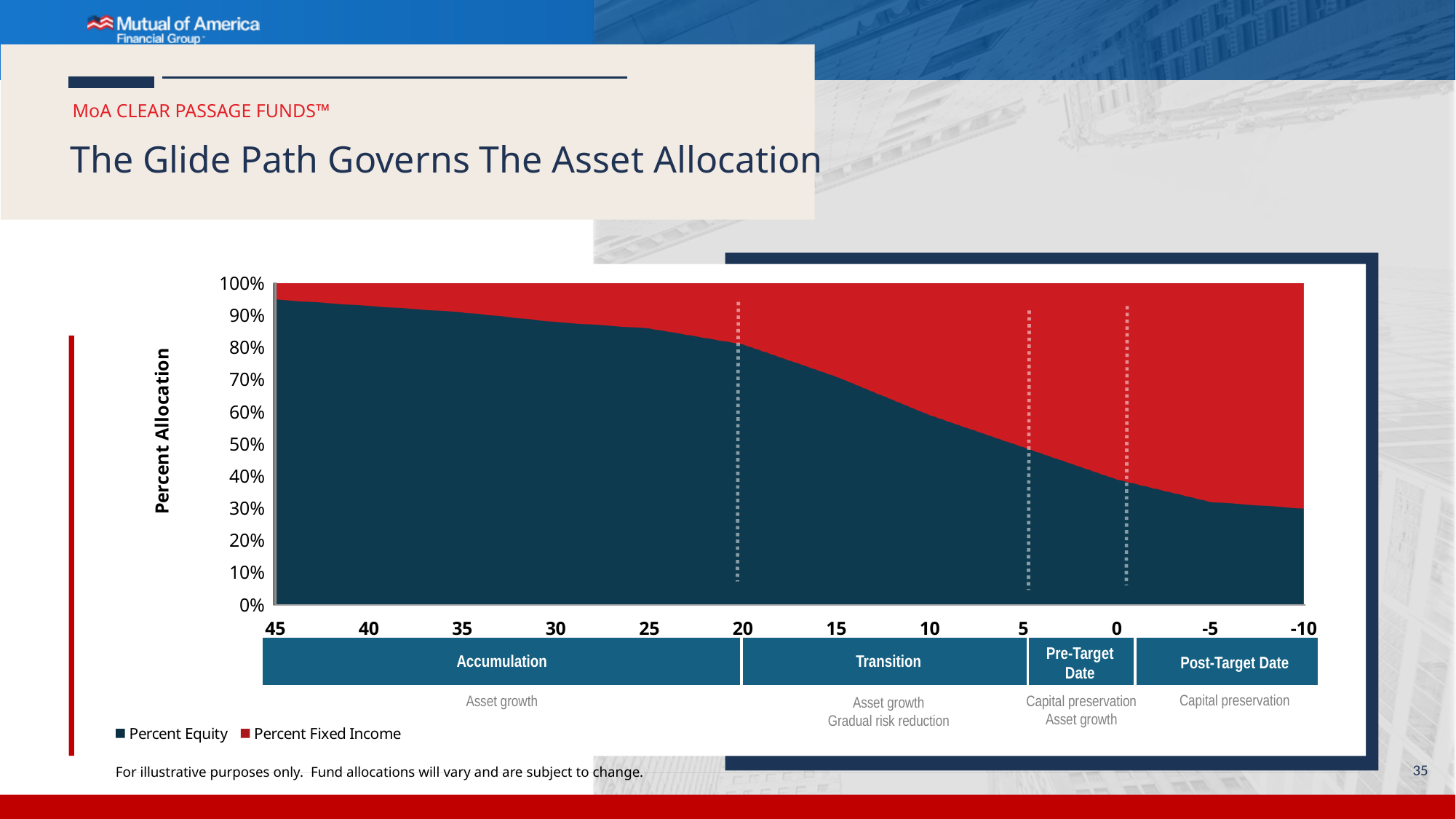
Is the Percent Equity value at x = -10 greater or less than 40%? less Is the Percent Equity value at x = 0 greater or less than 50%? less How many series does the chart legend list? 2 At x = 45, which series has the larger share: Percent Equity or Percent Fixed Income? Percent Equity What kind of chart is shown on the slide? Stacked area chart Does the Percent Equity allocation rise or fall as the x axis moves from 45 to -10? Falls Is the Percent Equity value at x = 20 greater or less than 70%? greater What are the two series named in the chart legend? Percent Equity and Percent Fixed Income What is the title of the chart's y axis? Percent Allocation At x = -10, which series has the larger share: Percent Equity or Percent Fixed Income? Percent Fixed Income How many tick labels are shown along the x axis of the chart? 12